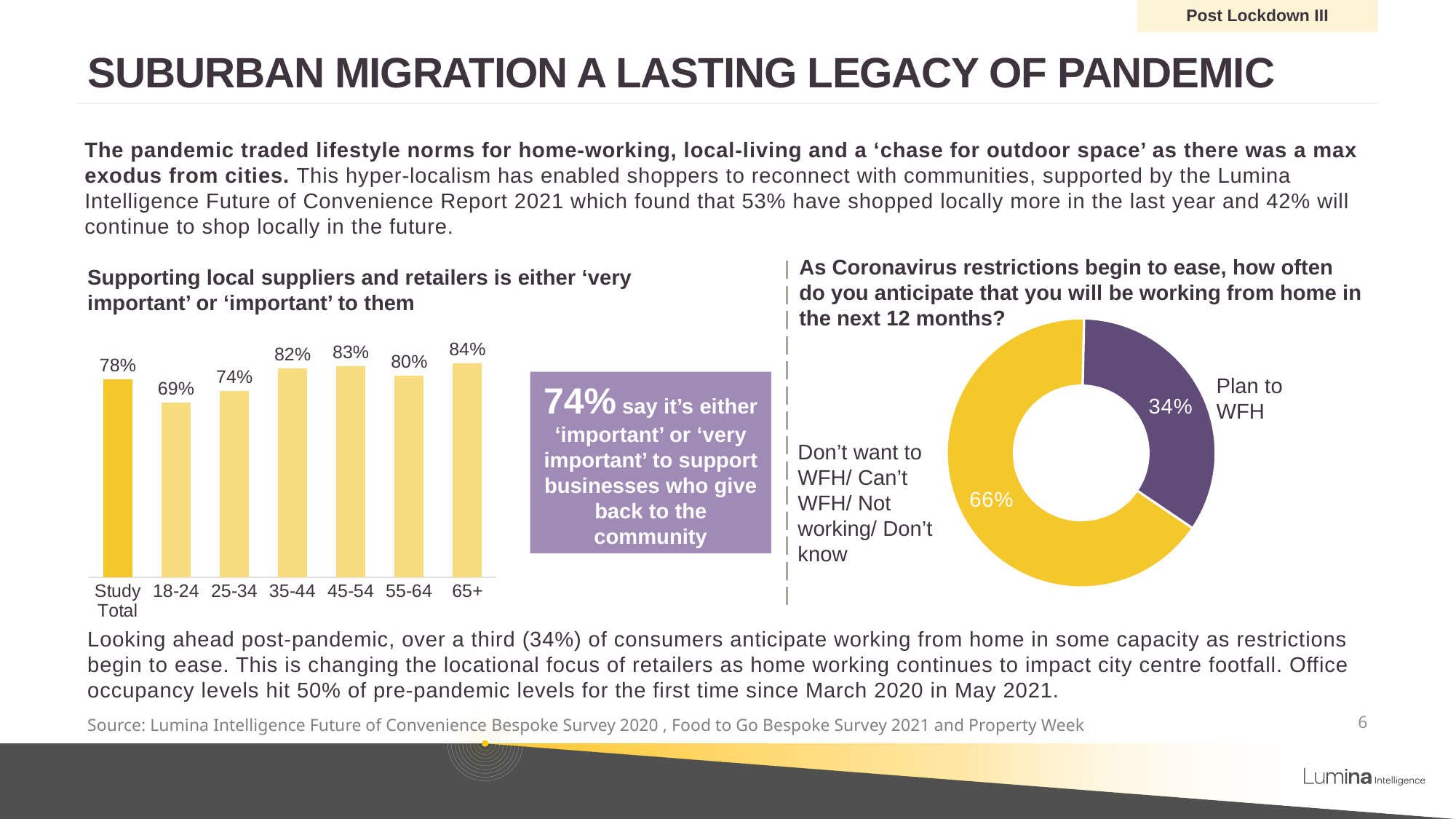
What kind of chart is the chart on the left of the slide? Bar chart How many categories are shown in the bar chart on the left? 7 In the donut chart on the right, which segment is larger, 'Plan to WFH' or 'Don't want to WFH/ Can't WFH/ Not working/ Don't know'? Don't want to WFH/ Can't WFH/ Not working/ Don't know In the bar chart on the left, which category has the lowest value? 18-24 In the donut chart on the right, what share of respondents plan to WFH? 34% In the bar chart on the left, what is the value for Study Total? 78% In the bar chart on the left, which bar is shown in a darker shade of yellow than the others? Study Total In the donut chart on the right, what is the value for 'Don't want to WFH/ Can't WFH/ Not working/ Don't know'? 66% In the bar chart on the left, what is the difference between the 65+ and 18-24 values? 15% In the bar chart on the left, which is larger, the value for 35-44 or the value for 55-64? 35-44 In the bar chart on the left, which age group has the highest value? 65+ In the bar chart on the left, what is the value for the 18-24 age group? 69%